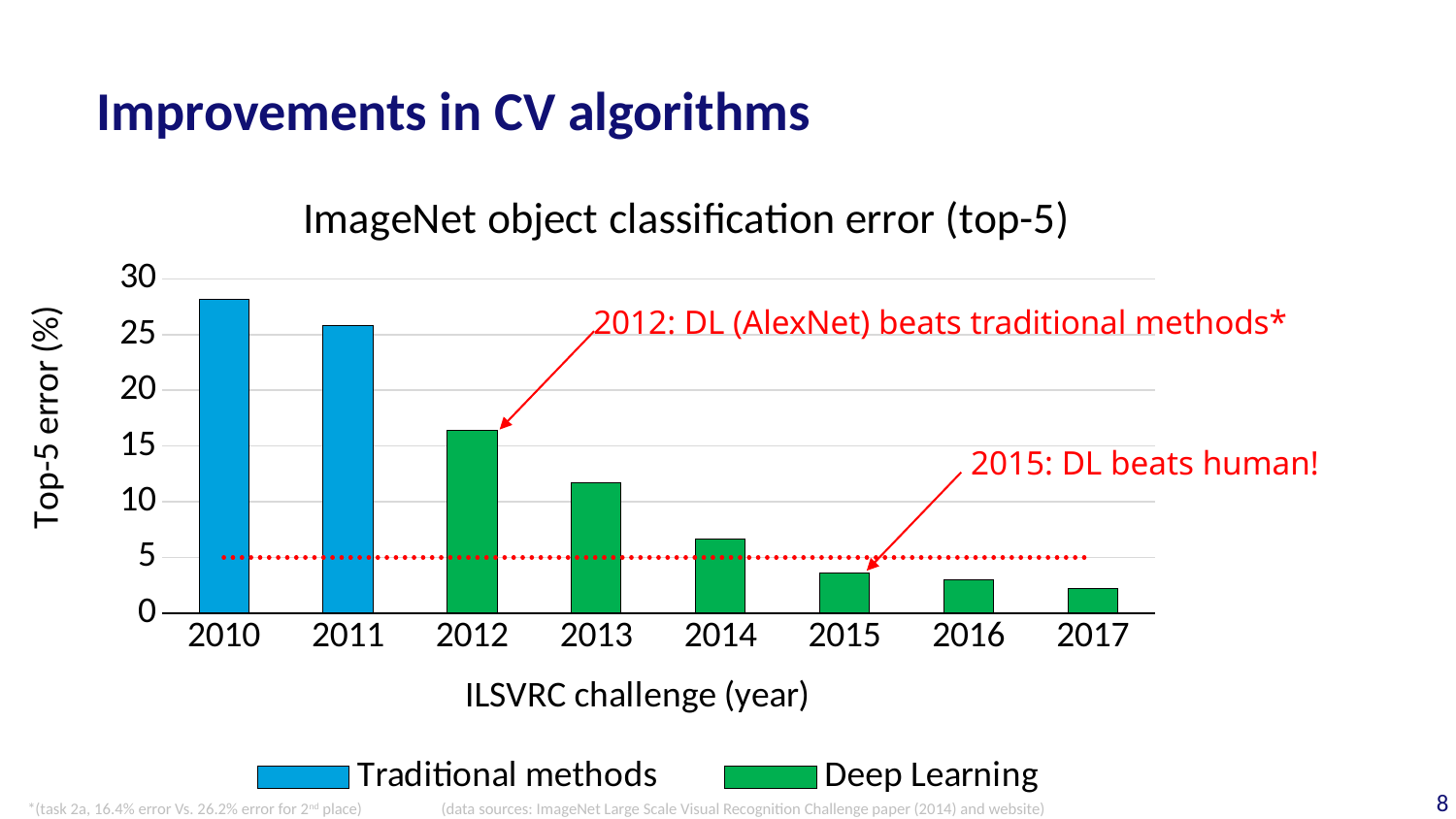
How many years are shown on the x axis of the chart? 8 Is the top-5 error for 2015 greater or less than 5? less Which year has the highest top-5 error? 2010 Which year has the lowest top-5 error? 2017 Do the top-5 error values rise or fall from 2010 to 2017? fall What is the title of the chart? ImageNet object classification error (top-5) How many series does the legend list? 2 Which legend entry is shown in green? Deep Learning Is the top-5 error for 2010 greater or less than 25? greater Which year has a larger top-5 error, 2012 or 2013? 2012 What kind of chart is shown on the slide? bar chart Is the top-5 error for 2013 greater or less than 10? greater